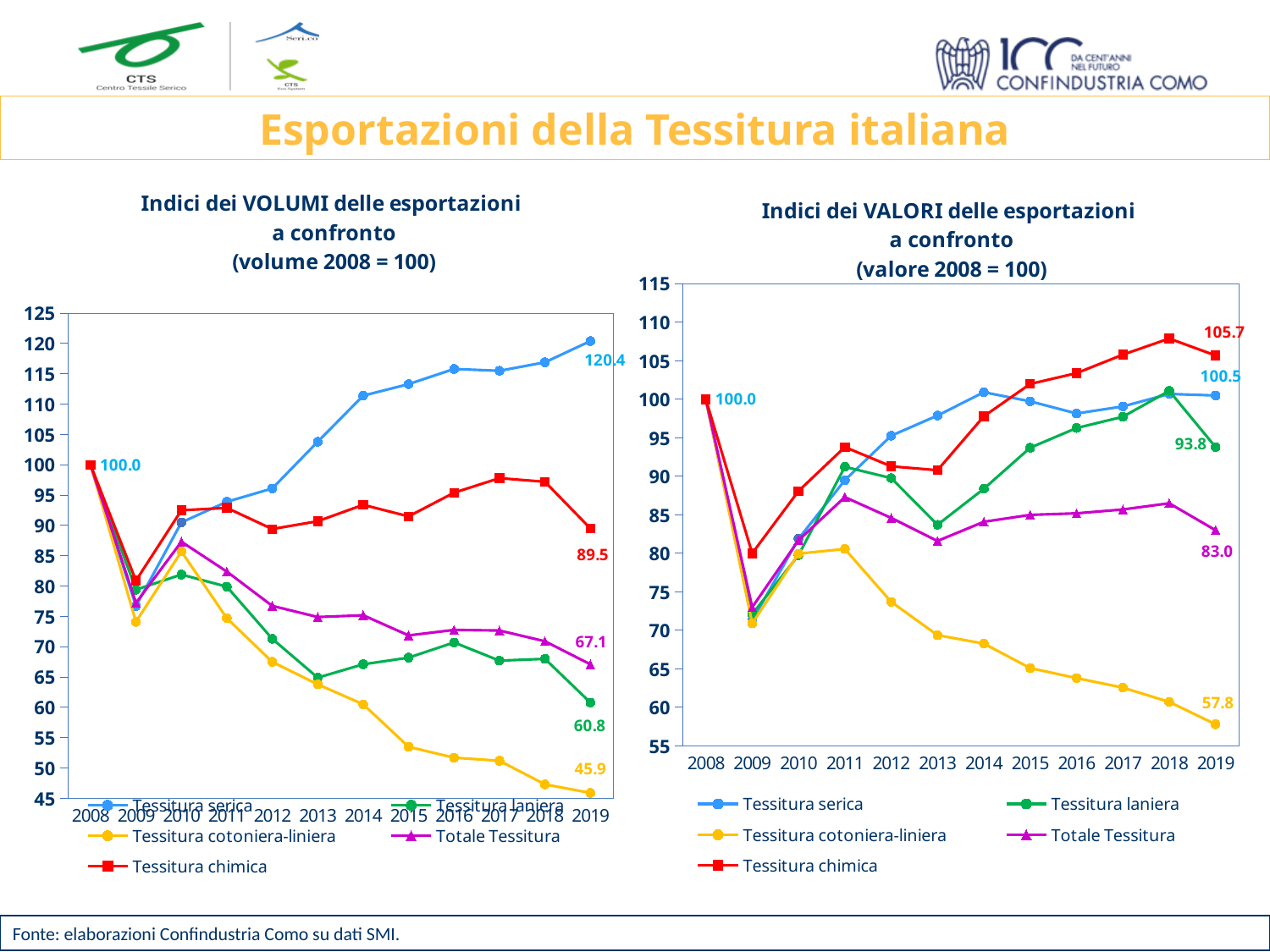
In the right chart (Indici dei VALORI delle esportazioni), which series has the highest value in 2019? Tessitura chimica How many series does the legend of the left chart (Indici dei VOLUMI delle esportazioni) list? 5 In the left chart (Indici dei VOLUMI delle esportazioni), what is the 2019 value for Tessitura serica? 120.4 In the left chart (Indici dei VOLUMI delle esportazioni), does the Tessitura cotoniera-liniera series rise or fall from 2010 to 2019? Fall What kind of chart is the right chart (Indici dei VALORI delle esportazioni)? Line chart In the right chart (Indici dei VALORI delle esportazioni), what is the difference between the 2019 values of Tessitura laniera and Tessitura cotoniera-liniera? 36.0 How many years are shown on the x axis of the right chart (Indici dei VALORI delle esportazioni)? 12 In the right chart (Indici dei VALORI delle esportazioni), which is larger in 2019: Tessitura serica or Tessitura laniera? Tessitura serica In the left chart (Indici dei VOLUMI delle esportazioni), is the 2014 value for Tessitura serica greater or less than 110? greater In the right chart (Indici dei VALORI delle esportazioni), what is the 2019 value for Tessitura chimica? 105.7 In the left chart (Indici dei VOLUMI delle esportazioni), which series has the lowest value in 2019? Tessitura cotoniera-liniera In the left chart (Indici dei VOLUMI delle esportazioni), what is the difference between the 2019 values of Tessitura serica and Tessitura chimica? 30.9